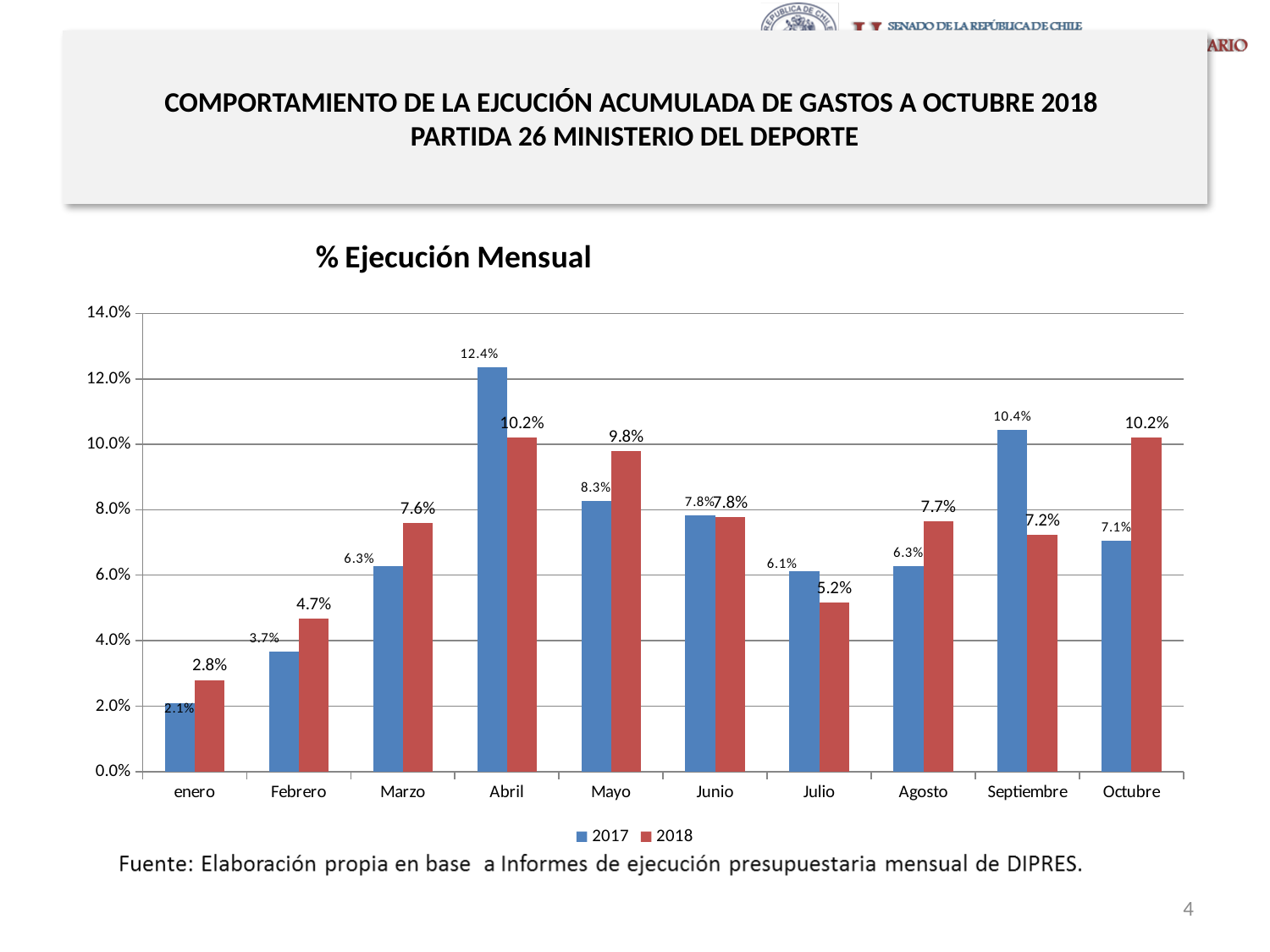
Which is larger in Septiembre, the 2017 value or the 2018 value? 2017 What is the difference between the 2017 and 2018 values in Abril? 2.2% Which is larger in Octubre, the 2017 value or the 2018 value? 2018 What is the value for 2017 in Abril? 12.4% What kind of chart is shown? Bar chart Which month has the highest value for the 2017 series? Abril What is the value for 2018 in Mayo? 9.8% What is the title of the chart? % Ejecución Mensual What is the value for 2018 in enero? 2.8% How many months are shown on the x axis? 10 Which month has the lowest value for the 2018 series? enero How many series does the legend list? 2